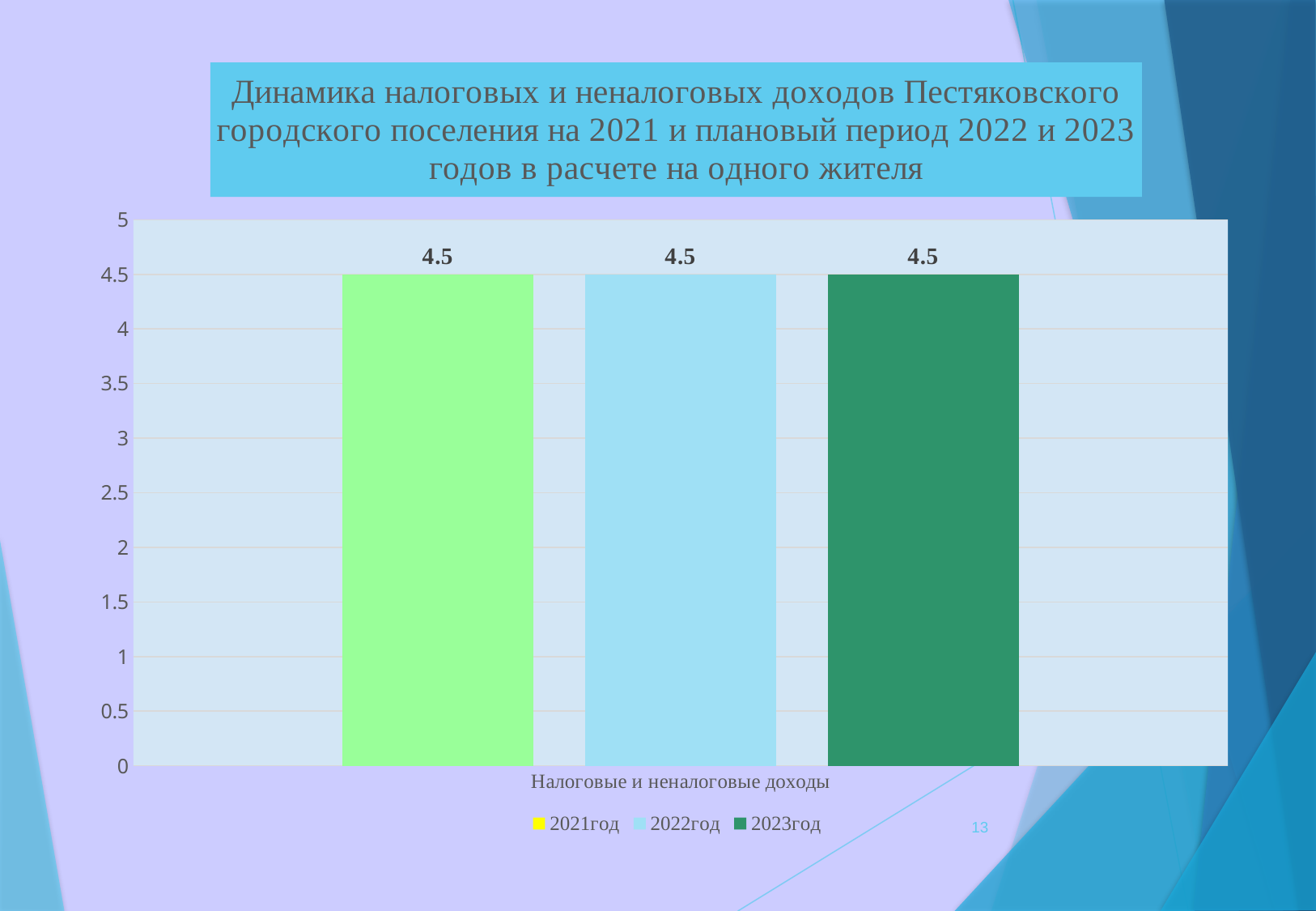
What is the difference between the values for 2023год and 2021год? 0 How many categories are shown on the x axis? 1 Is the value for 2022год greater or less than 4? greater How many series does the legend list? 3 Do the values rise, fall or stay the same from 2021год to 2023год? stay the same Is the value for 2023год greater or less than 5? less What is the value for 2021год in the chart? 4.5 What is the value for 2022год in the chart? 4.5 What kind of chart is shown on the slide? bar chart What is the highest value shown on the y axis? 5 What is the value for 2023год in the chart? 4.5 What is the category label shown on the x axis? Налоговые и неналоговые доходы